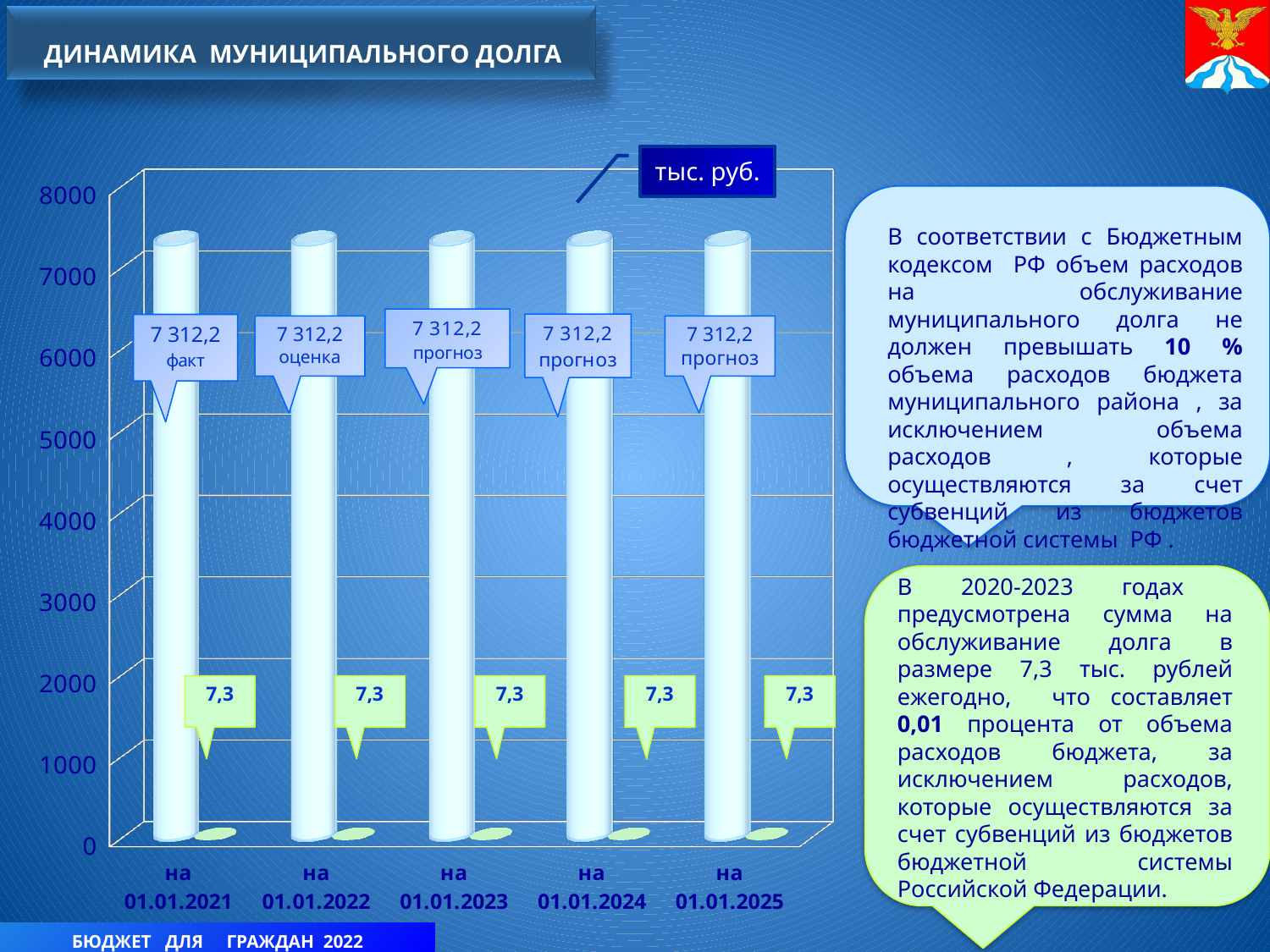
What unit of measurement is indicated on the chart? тыс. руб. What status label accompanies the value for 01.01.2022? оценка What kind of chart is shown on the slide? bar chart What status label accompanies the value for 01.01.2021? факт Do the municipal debt values rise, fall or stay the same from 01.01.2021 to 01.01.2025? stay the same What is the difference between the municipal debt values for 01.01.2022 and 01.01.2024? 0 Is the municipal debt value for 01.01.2021 greater or less than 8000? less What is the debt servicing amount shown in the green label for 01.01.2023? 7,3 What is the municipal debt value shown for 01.01.2021? 7 312,2 What is the municipal debt value shown for 01.01.2025? 7 312,2 How many dates (categories) are plotted on the chart? 5 Is the municipal debt value for 01.01.2023 greater or less than 7000? greater